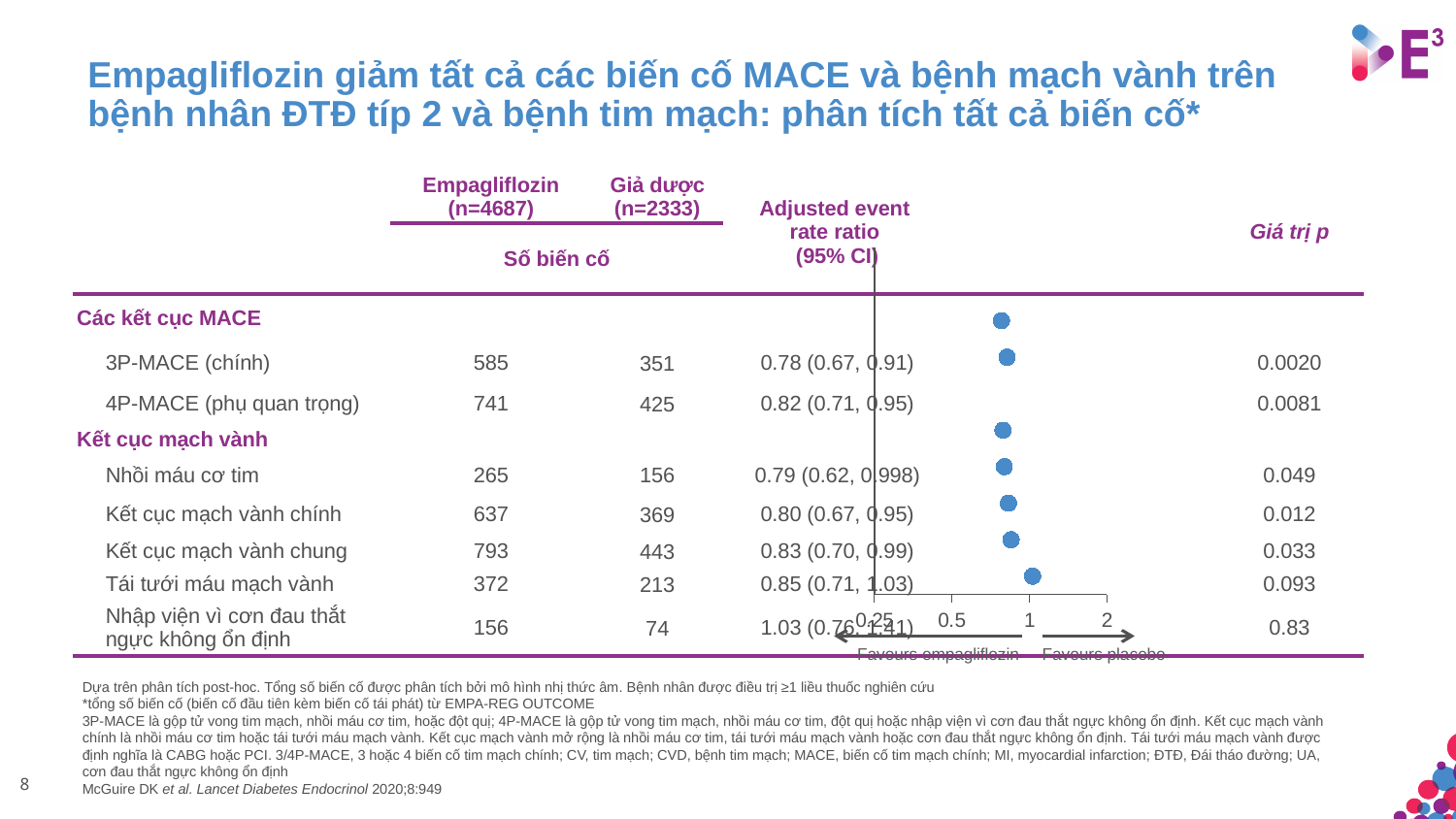
Is the adjusted event rate ratio for Kết cục mạch vành chung greater or less than 0.5? greater What is the difference between the adjusted event rate ratios of Tái tưới máu mạch vành and 3P-MACE (chính)? 0.07 Which outcome has the highest adjusted event rate ratio? Nhập viện vì cơn đau thắt ngực không ổn định How many events (Số biến cố) were recorded for 4P-MACE in the Empagliflozin group? 741 Is the adjusted event rate ratio for Tái tưới máu mạch vành greater or less than 1? less What is the adjusted event rate ratio (95% CI) for 3P-MACE (chính)? 0.78 (0.67, 0.91) What tick values are shown on the x axis of the forest plot? 0.25, 0.5, 1, 2 What is the p value (Giá trị p) for Kết cục mạch vành chính? 0.012 What kind of chart is shown on the slide? dot plot (forest plot) What is the adjusted event rate ratio (95% CI) for Nhồi máu cơ tim? 0.79 (0.62, 0.998) Which has the larger adjusted event rate ratio, Tái tưới máu mạch vành or 3P-MACE (chính)? Tái tưới máu mạch vành